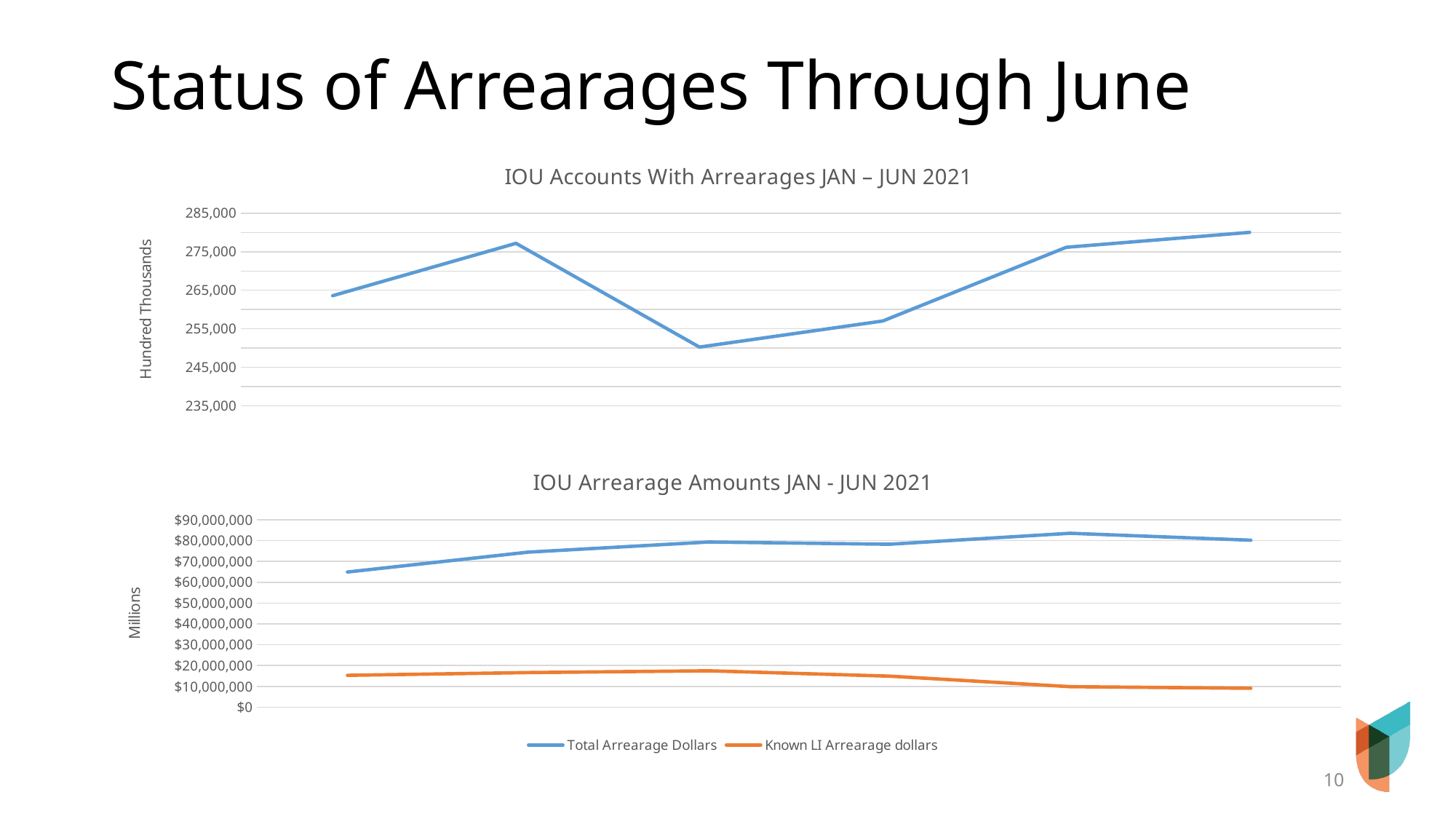
How many data points does the line in the top chart, 'IOU Accounts With Arrearages JAN – JUN 2021', have? 6 How many series does the legend of the bottom chart, 'IOU Arrearage Amounts JAN - JUN 2021', list? 2 What kind of chart is the top chart, 'IOU Accounts With Arrearages JAN – JUN 2021'? Line chart What is the vertical axis label of the top chart, 'IOU Accounts With Arrearages JAN – JUN 2021'? Hundred Thousands What kind of chart is the bottom chart, 'IOU Arrearage Amounts JAN - JUN 2021'? Line chart In the bottom chart, 'IOU Arrearage Amounts JAN - JUN 2021', does the Known LI Arrearage dollars line rise or fall over the last three points? Fall In the top chart, 'IOU Accounts With Arrearages JAN – JUN 2021', is the highest point on the line greater or less than 275,000? greater In the top chart, 'IOU Accounts With Arrearages JAN – JUN 2021', is the lowest point on the line greater or less than 255,000? less In the top chart, 'IOU Accounts With Arrearages JAN – JUN 2021', does the line rise or fall over the last three points? Rise In the bottom chart, 'IOU Arrearage Amounts JAN - JUN 2021', is the highest point of the Known LI Arrearage dollars line greater or less than $20,000,000? less In the bottom chart, 'IOU Arrearage Amounts JAN - JUN 2021', which series is plotted higher throughout: Total Arrearage Dollars or Known LI Arrearage dollars? Total Arrearage Dollars